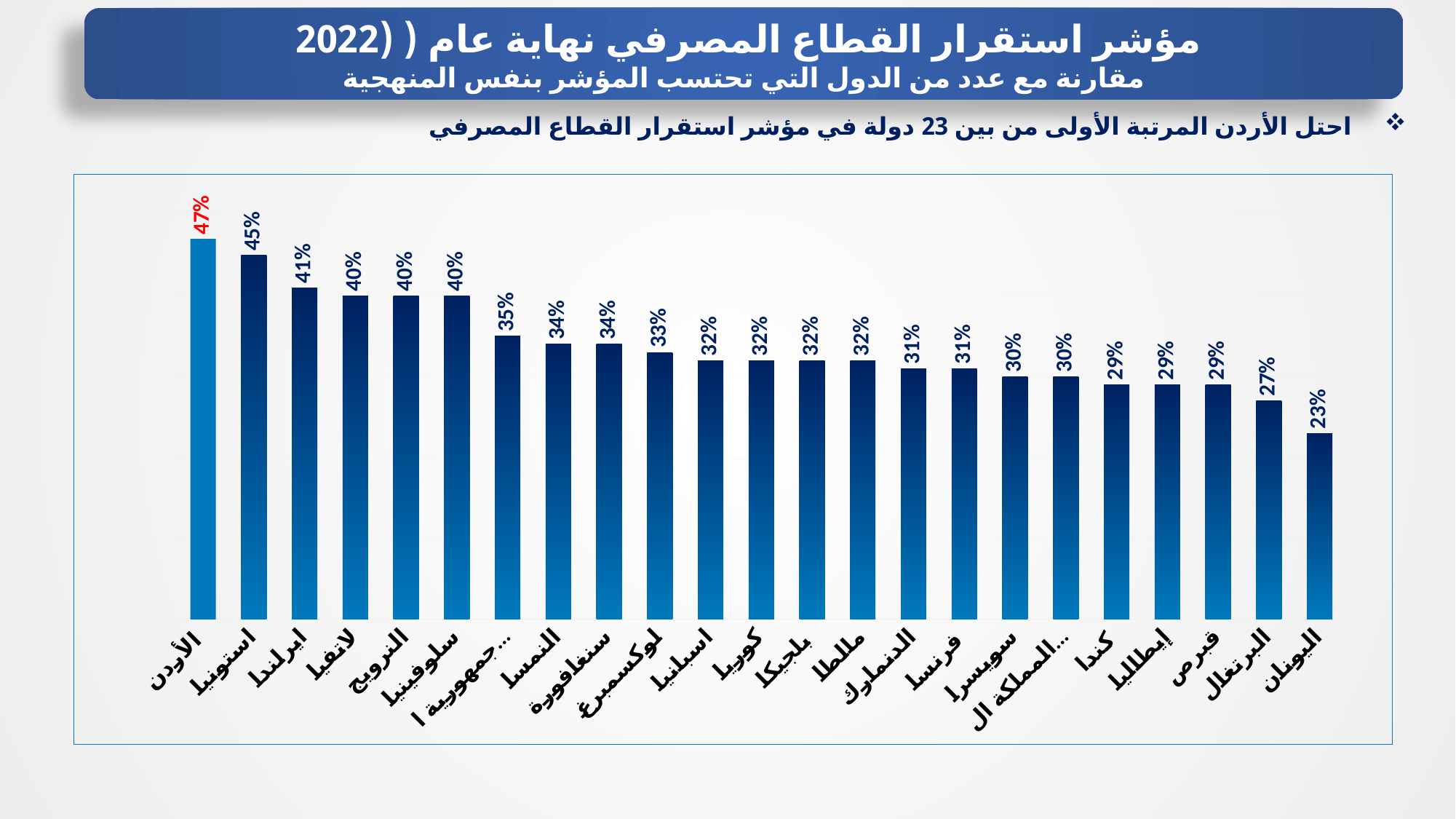
What kind of chart is shown on the slide? bar chart What is the difference between the values for الأردن and اليونان? 24% How many countries are shown in the chart? 23 Which is larger, the value for ايرلندا or the value for النمسا? ايرلندا Which country has the highest value? الأردن What is the value for استونيا? 45% What is the value for لوكسمبرغ? 33% What is the value for الأردن? 47% Which country has the lowest value? اليونان What is the difference between the values for الأردن and استونيا? 2% Do the values rise or fall from left to right along the x axis? fall What is the value for اليونان? 23%